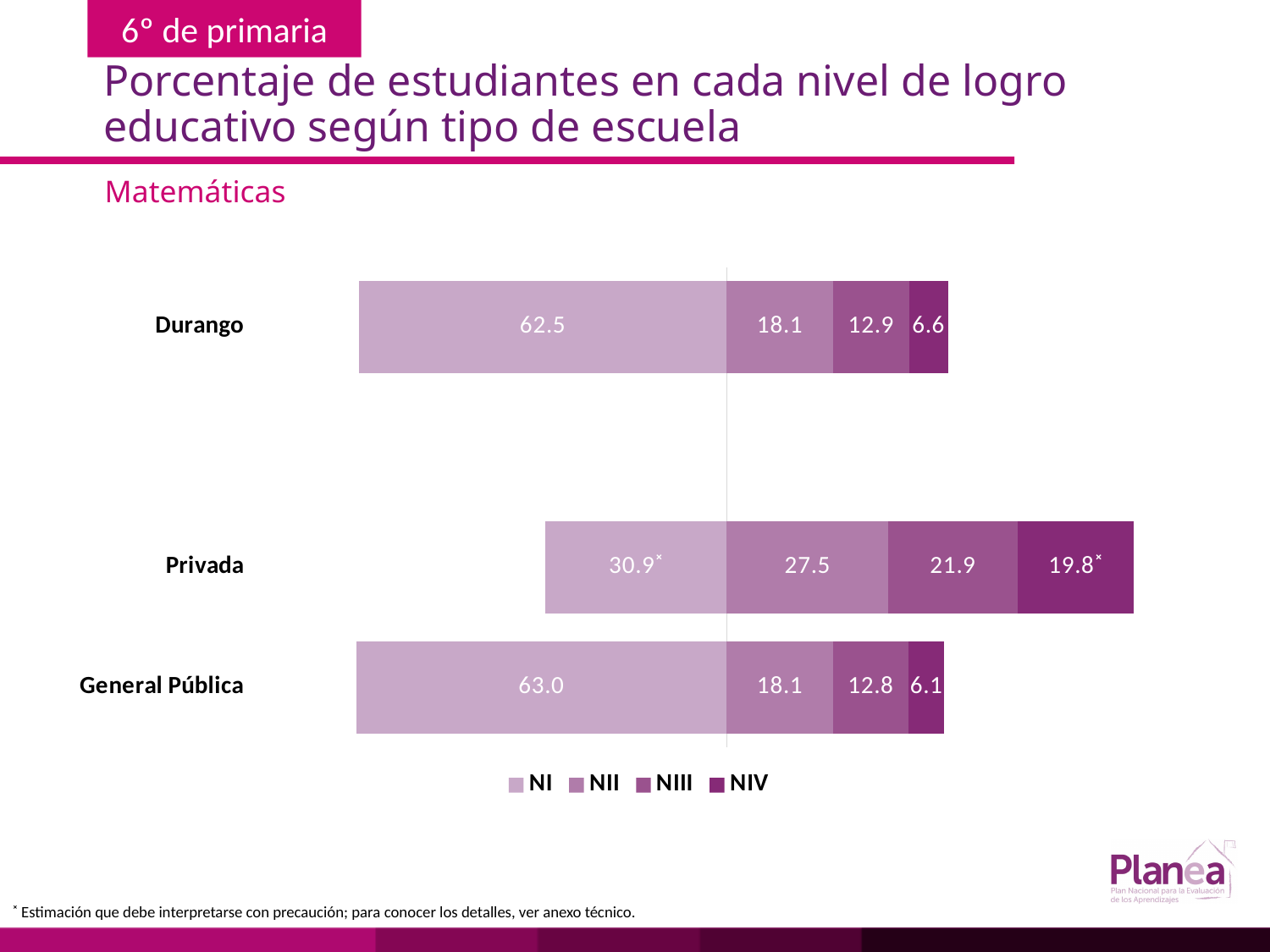
Which school type has the highest NI value? General Pública How many series does the legend list? 4 What is the NIII value for Durango? 12.9 What kind of chart is shown on the slide? Stacked bar chart Which school type has the lowest NIV value? General Pública What is the NI value for Durango? 62.5 Which is larger, the NIII value for Durango or the NIII value for General Pública? Durango What is the NII value for Privada? 27.5 What is the total of the stacked bar for Durango? 100.1 How many school types are shown in the chart? 3 What is the NIV value for General Pública? 6.1 What is the difference between the NIII value for Privada and the NIII value for Durango? 9.0